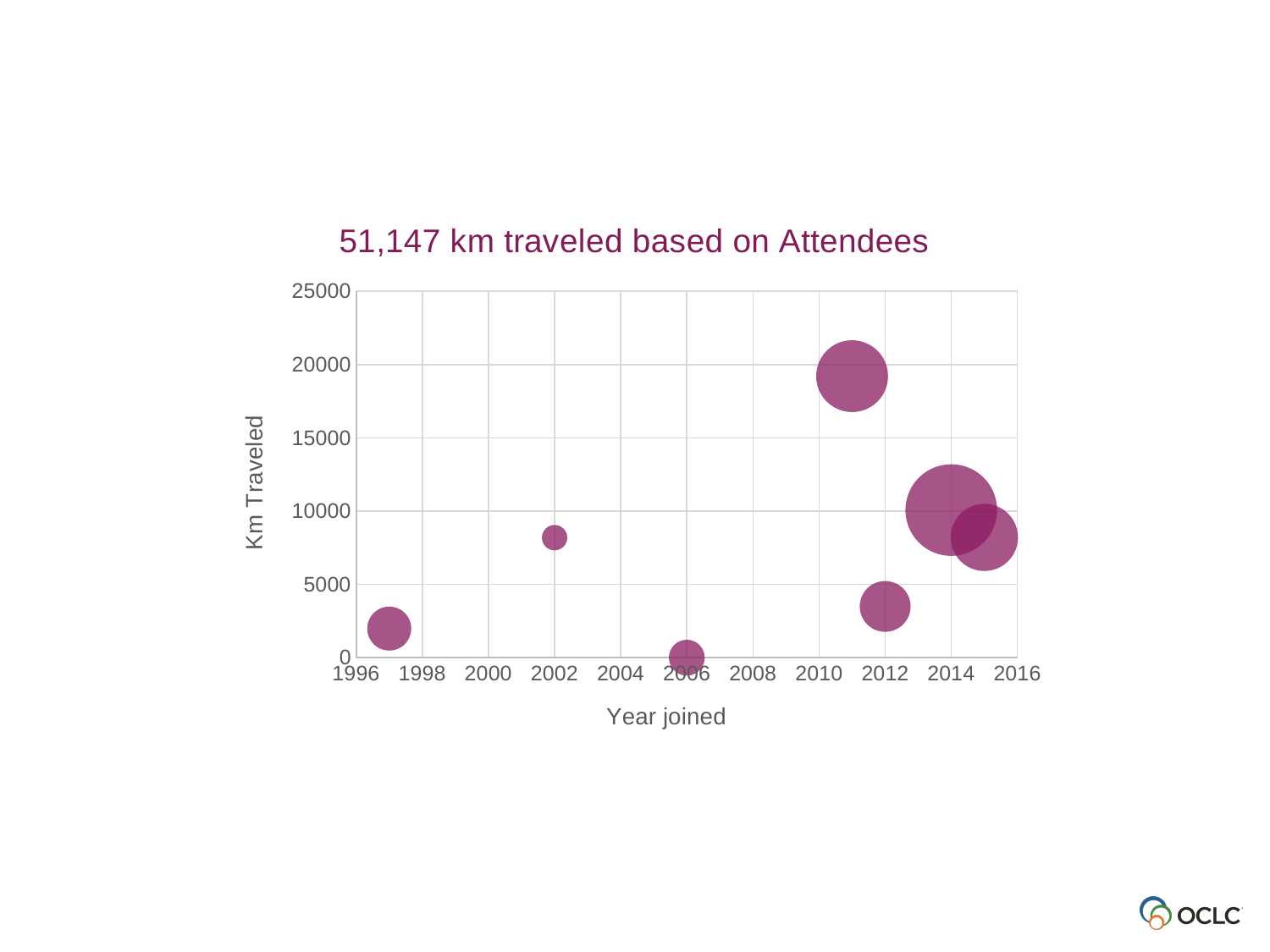
What type of chart is shown on the slide? Bubble chart Which year joined has the lowest Km Traveled value? 2006 Is the Km Traveled value for the bubble at 2012 greater or less than 5000? less Which has a larger Km Traveled value, the bubble at 2011 or the bubble at 2012? 2011 Is the Km Traveled value for the bubble at 1997 greater or less than 5000? less Which has a larger Km Traveled value, the bubble at 2002 or the bubble at 1997? 2002 Is the Km Traveled value for the bubble at 2011 greater or less than 15000? greater What is the label of the x axis? Year joined Which year joined has the highest Km Traveled value? 2011 What is the title of the chart? 51,147 km traveled based on Attendees How many bubbles are plotted on the chart? 7